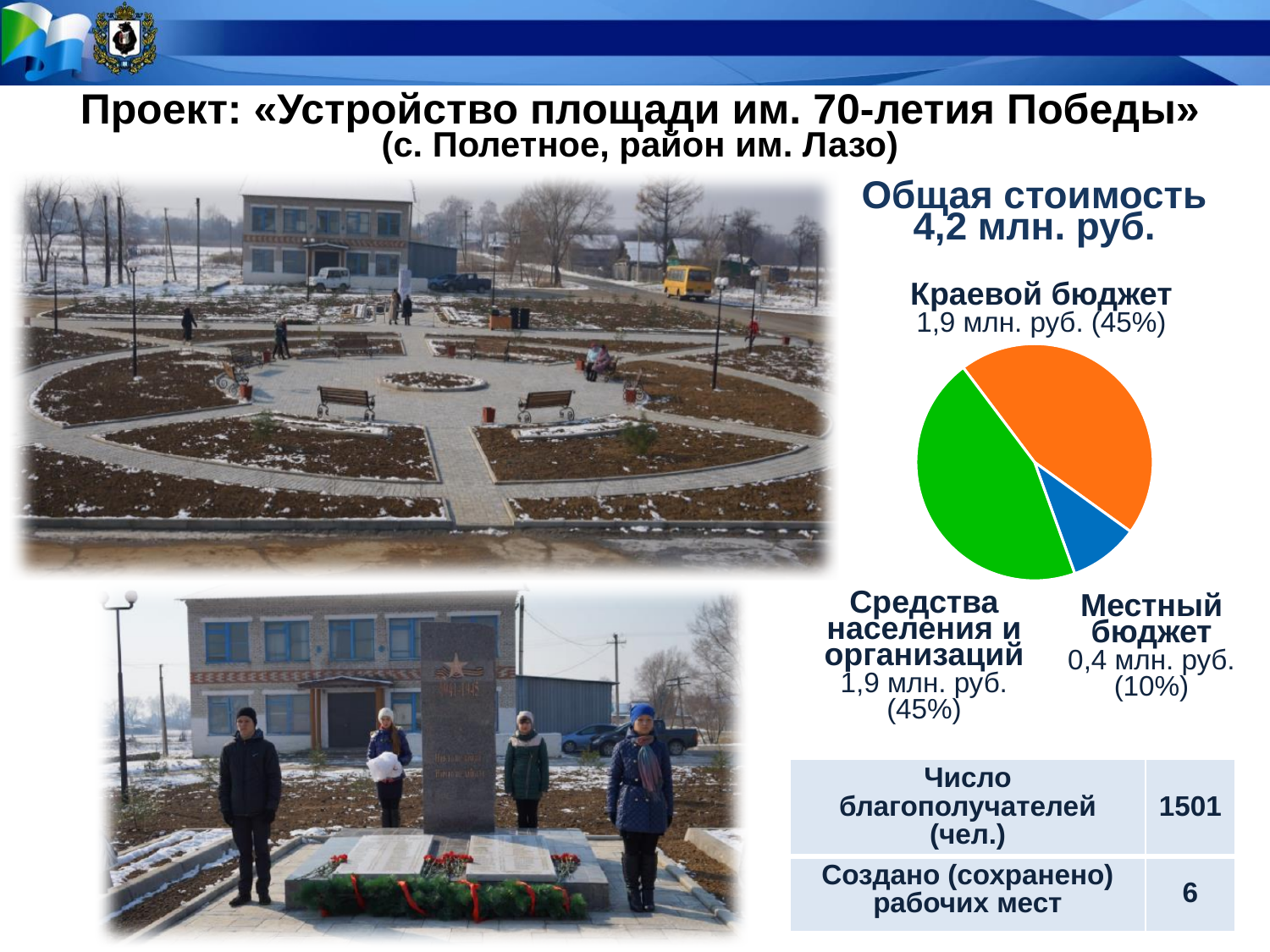
What share of the pie does Краевой бюджет represent? 45% What is the value for Средства населения и организаций? 1,9 млн. руб. What is the difference between Краевой бюджет and Местный бюджет? 1,5 млн. руб. Which source has the smallest share in the pie chart? Местный бюджет Which is larger, Краевой бюджет or Местный бюджет? Краевой бюджет What is the total cost (Общая стоимость) shown above the pie chart? 4,2 млн. руб. What share of the pie does Местный бюджет represent? 10% What colour is the slice for Местный бюджет? blue What is the value for Местный бюджет? 0,4 млн. руб. What is the value for Краевой бюджет? 1,9 млн. руб. What kind of chart is shown on the slide? pie chart How many slices does the pie chart have? 3